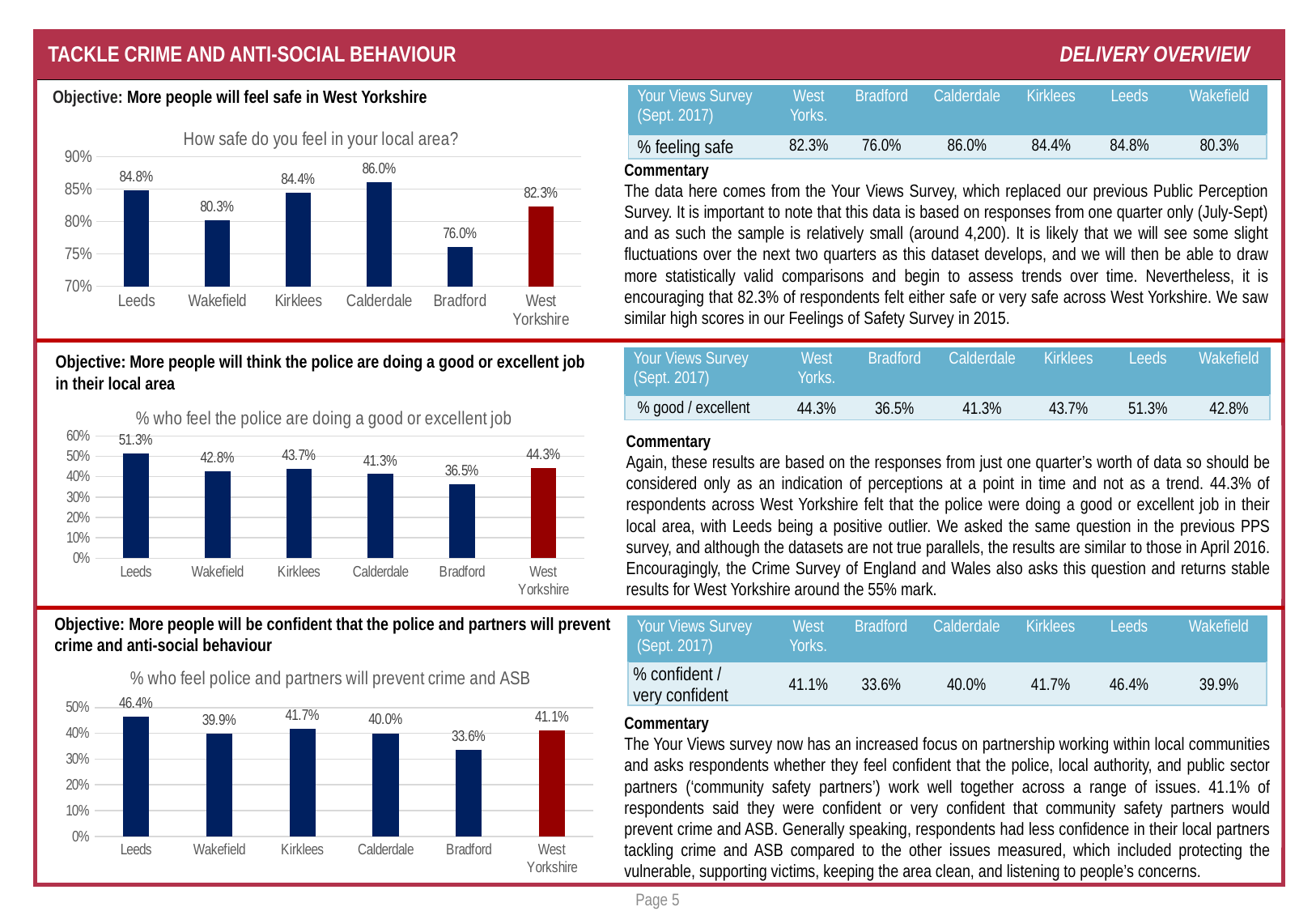
In the chart titled "% who feel the police are doing a good or excellent job", which area has the highest value? Leeds In the chart titled "How safe do you feel in your local area?", how many bars are plotted? 6 In the chart titled "How safe do you feel in your local area?", which area has the lowest value? Bradford What type of chart is the chart titled "% who feel police and partners will prevent crime and ASB"? Bar chart In the chart titled "How safe do you feel in your local area?", what is the value for Calderdale? 86.0% In the chart titled "% who feel police and partners will prevent crime and ASB", what is the value for West Yorkshire? 41.1% In the chart titled "How safe do you feel in your local area?", what is the difference between Calderdale and Bradford? 10.0% In the chart titled "% who feel police and partners will prevent crime and ASB", which bar is coloured red rather than dark blue? West Yorkshire In the chart titled "% who feel police and partners will prevent crime and ASB", which area has the lowest value? Bradford In the chart titled "% who feel the police are doing a good or excellent job", what is the value for Leeds? 51.3% In the chart titled "% who feel the police are doing a good or excellent job", what is the difference between West Yorkshire and Bradford? 7.8% In the chart titled "% who feel the police are doing a good or excellent job", is the value for Wakefield or Kirklees larger? Kirklees